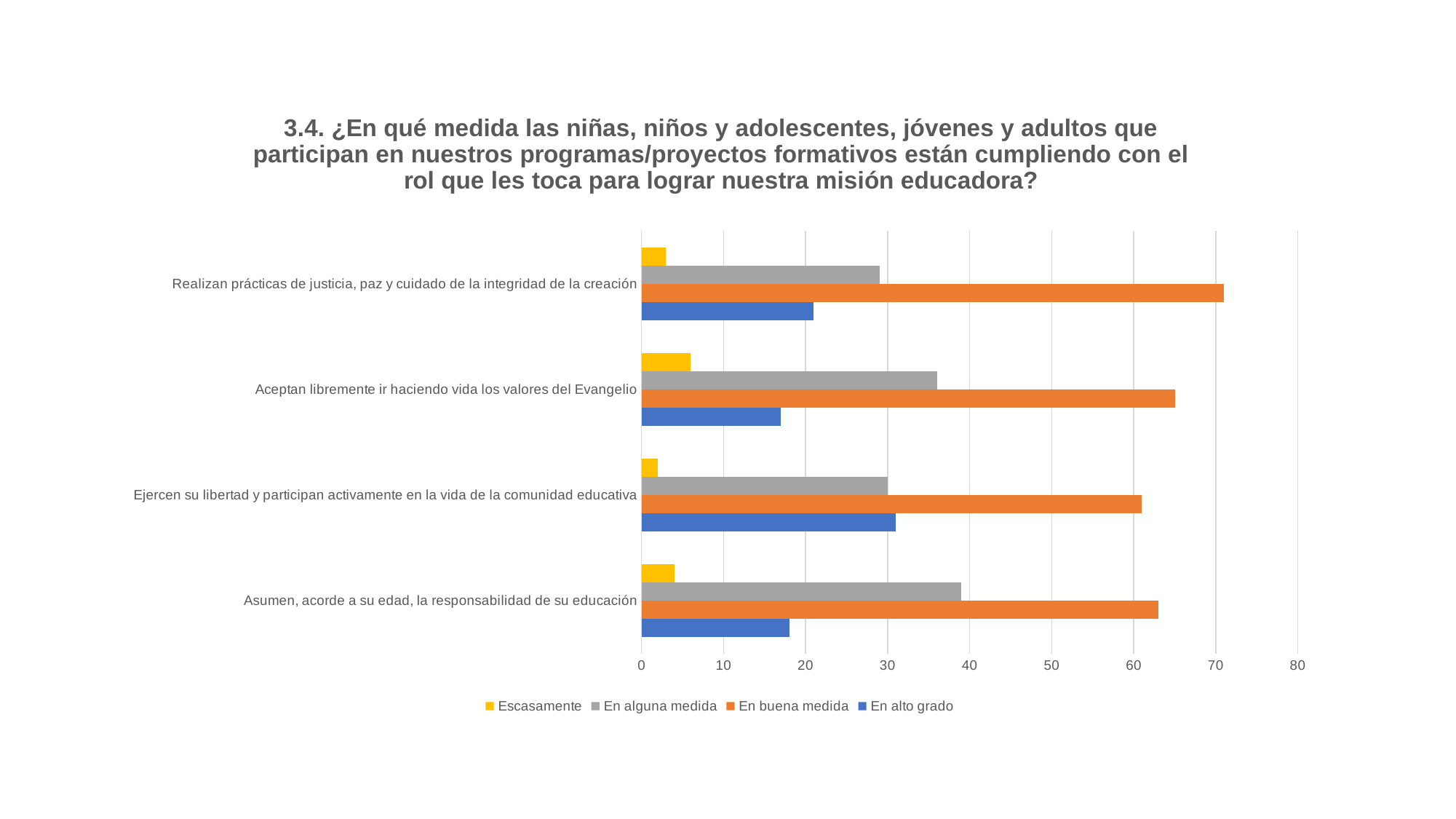
Which has the larger 'En alto grado' value: 'Ejercen su libertad y participan activamente en la vida de la comunidad educativa' or 'Realizan prácticas de justicia, paz y cuidado de la integridad de la creación'? Ejercen su libertad y participan activamente en la vida de la comunidad educativa Is the 'Escasamente' value for 'Aceptan libremente ir haciendo vida los valores del Evangelio' greater or less than 10? less Is the 'En buena medida' value for 'Realizan prácticas de justicia, paz y cuidado de la integridad de la creación' greater or less than 60? greater Is the 'En alto grado' value for 'Ejercen su libertad y participan activamente en la vida de la comunidad educativa' greater or less than 20? greater Which category has the highest value for 'Escasamente'? Aceptan libremente ir haciendo vida los valores del Evangelio How many series does the legend list? 4 Which category has the highest value for 'En buena medida'? Realizan prácticas de justicia, paz y cuidado de la integridad de la creación Which series has the highest value for 'Aceptan libremente ir haciendo vida los valores del Evangelio'? En buena medida What colour represents the 'En buena medida' series in the legend? Orange What kind of chart is shown on the slide? Bar chart How many categories are plotted on the chart? 4